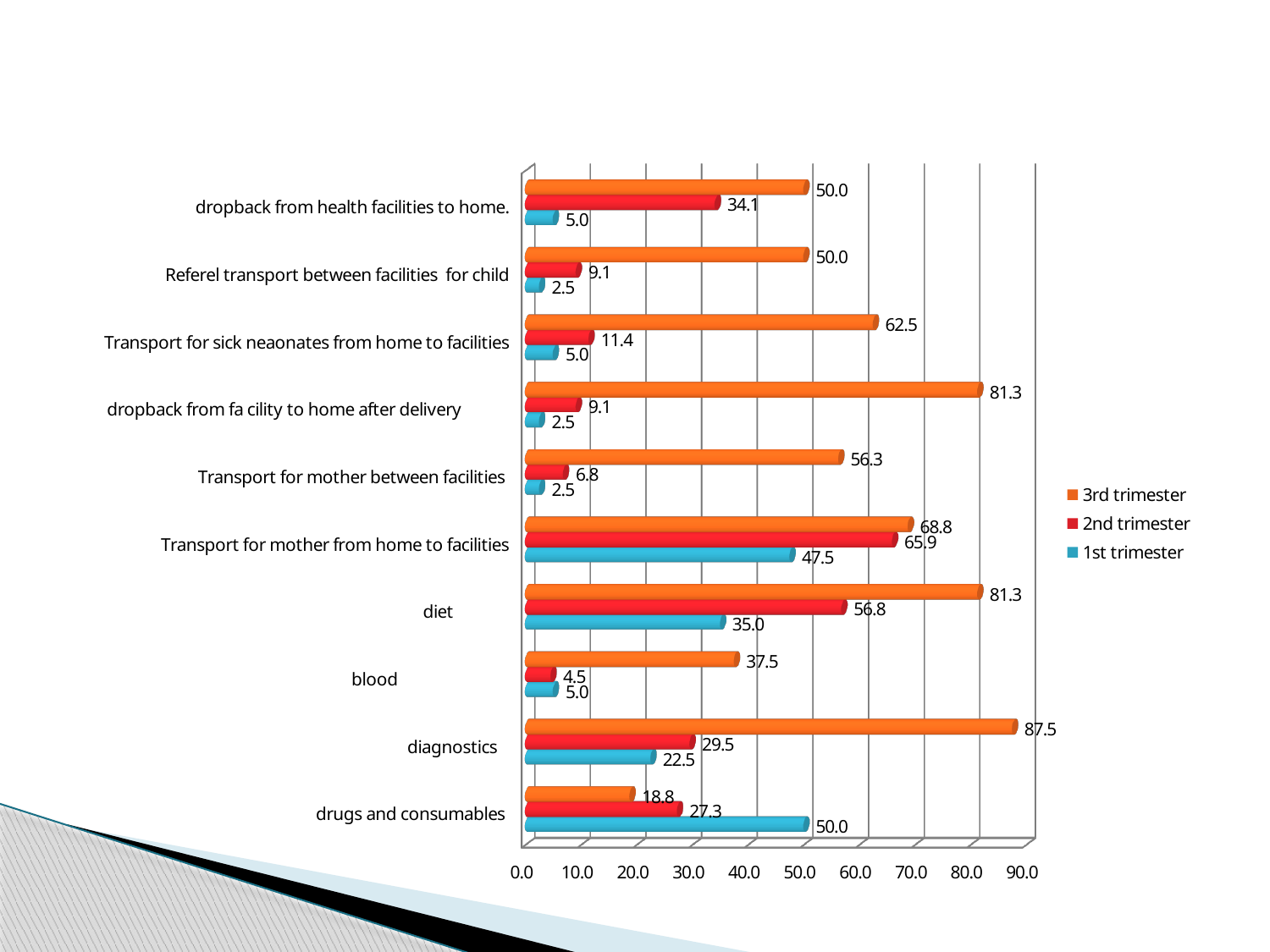
How many series does the legend list? 3 Which category has the highest 3rd trimester value? diagnostics What is the 2nd trimester value for diet? 56.8 What kind of chart is shown on the slide? bar chart For drugs and consumables, which is larger: the 1st trimester value or the 3rd trimester value? 1st trimester What is the 3rd trimester value for diagnostics? 87.5 What is the difference between the 3rd trimester and 1st trimester values for diet? 46.3 Which category has the highest 1st trimester value? drugs and consumables Which category has the lowest 3rd trimester value? drugs and consumables What is the 1st trimester value for drugs and consumables? 50.0 Which colour represents the 2nd trimester series? red How many categories are shown on the chart? 10